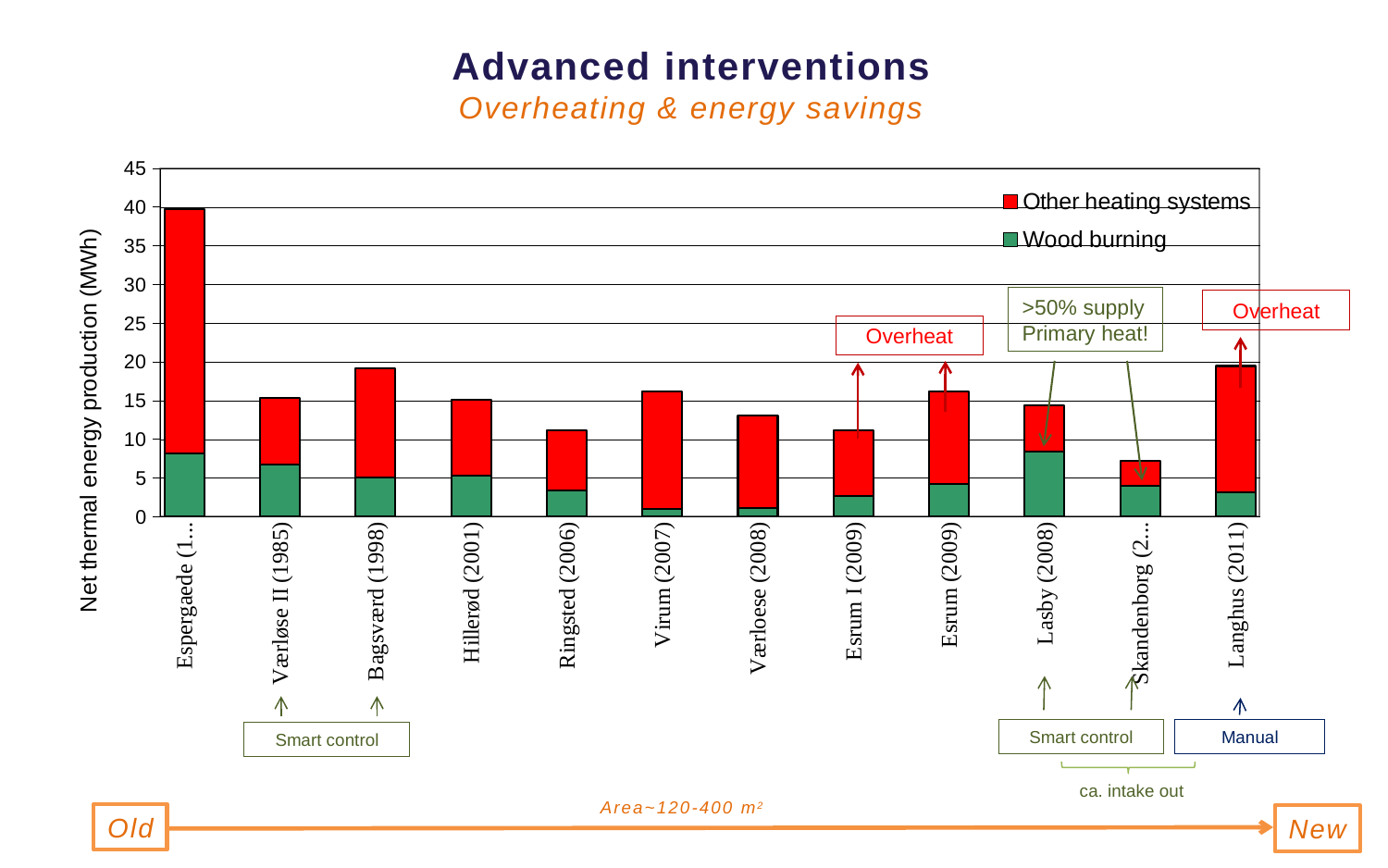
Which building has the highest total net thermal energy production? Espergaede Is the total net thermal energy production for Ringsted (2006) greater or less than 15 MWh? less Is the total net thermal energy production for Skandenborg greater or less than 10 MWh? less Which has the larger wood burning value, Lasby (2008) or Virum (2007)? Lasby (2008) Which has the larger total net thermal energy production, Hillerød (2001) or Ringsted (2006)? Hillerød (2001) Which building has the lowest total net thermal energy production? Skandenborg How many buildings (categories) are plotted on the x axis? 12 How many series does the chart legend list? 2 What kind of chart is shown on the slide? Stacked bar chart Is the total net thermal energy production for Espergaede greater or less than 35 MWh? greater What is the label of the y axis? Net thermal energy production (MWh)